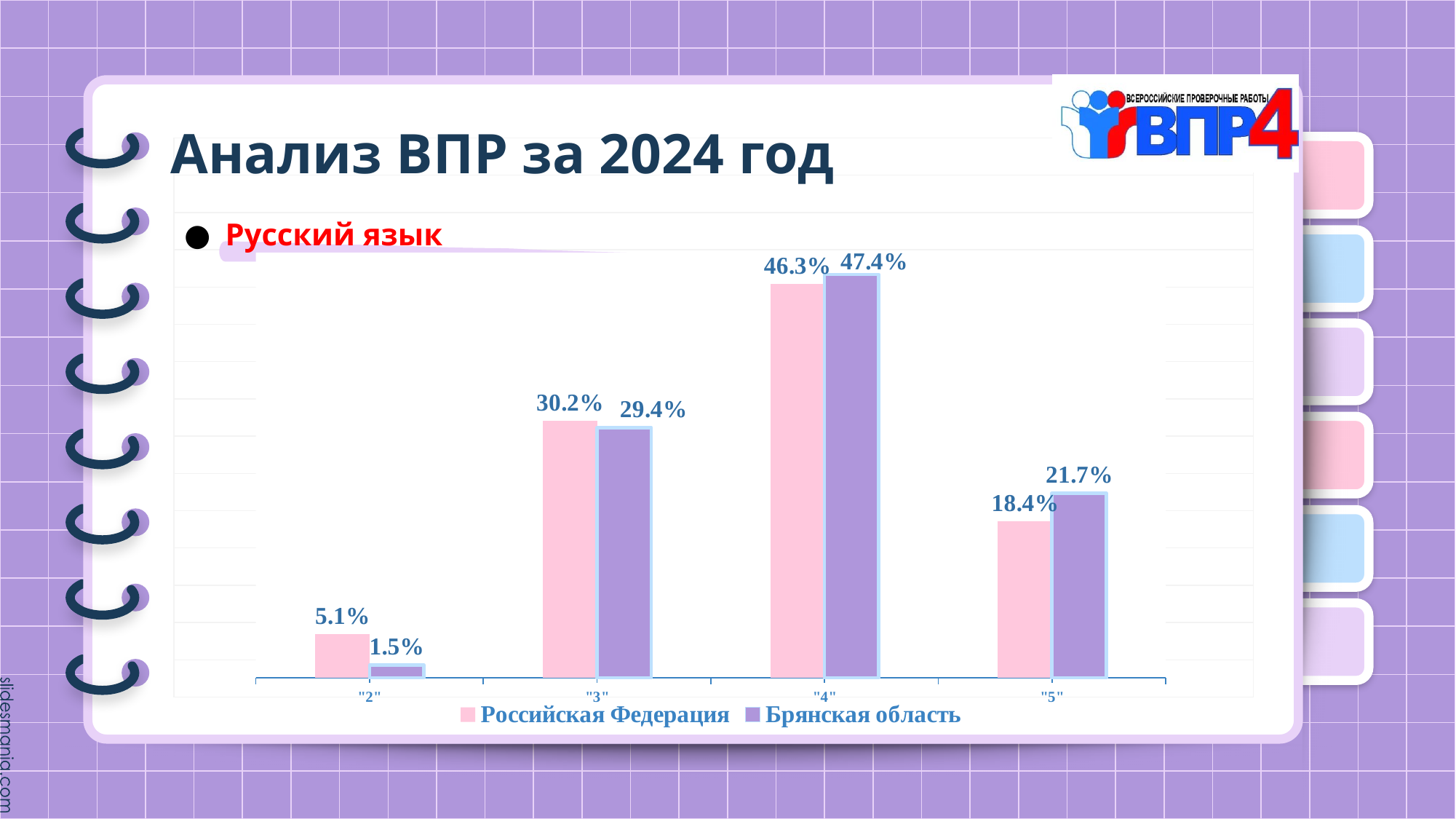
What is the difference between Российская Федерация and Брянская область in category "2"? 3.6% In category "3", which series has the larger value, Российская Федерация or Брянская область? Российская Федерация How many series does the legend list? 2 What is the value for Российская Федерация in category "2"? 5.1% What kind of chart is shown on the slide? Bar chart How many categories are shown on the x axis? 4 What is the value for Брянская область in category "5"? 21.7% Which category has the highest value for Брянская область? "4" What is the difference between Российская Федерация and Брянская область in category "5"? 3.3% Which category has the lowest value for Российская Федерация? "2" What is the value for Российская Федерация in category "3"? 30.2% What is the value for Брянская область in category "4"? 47.4%